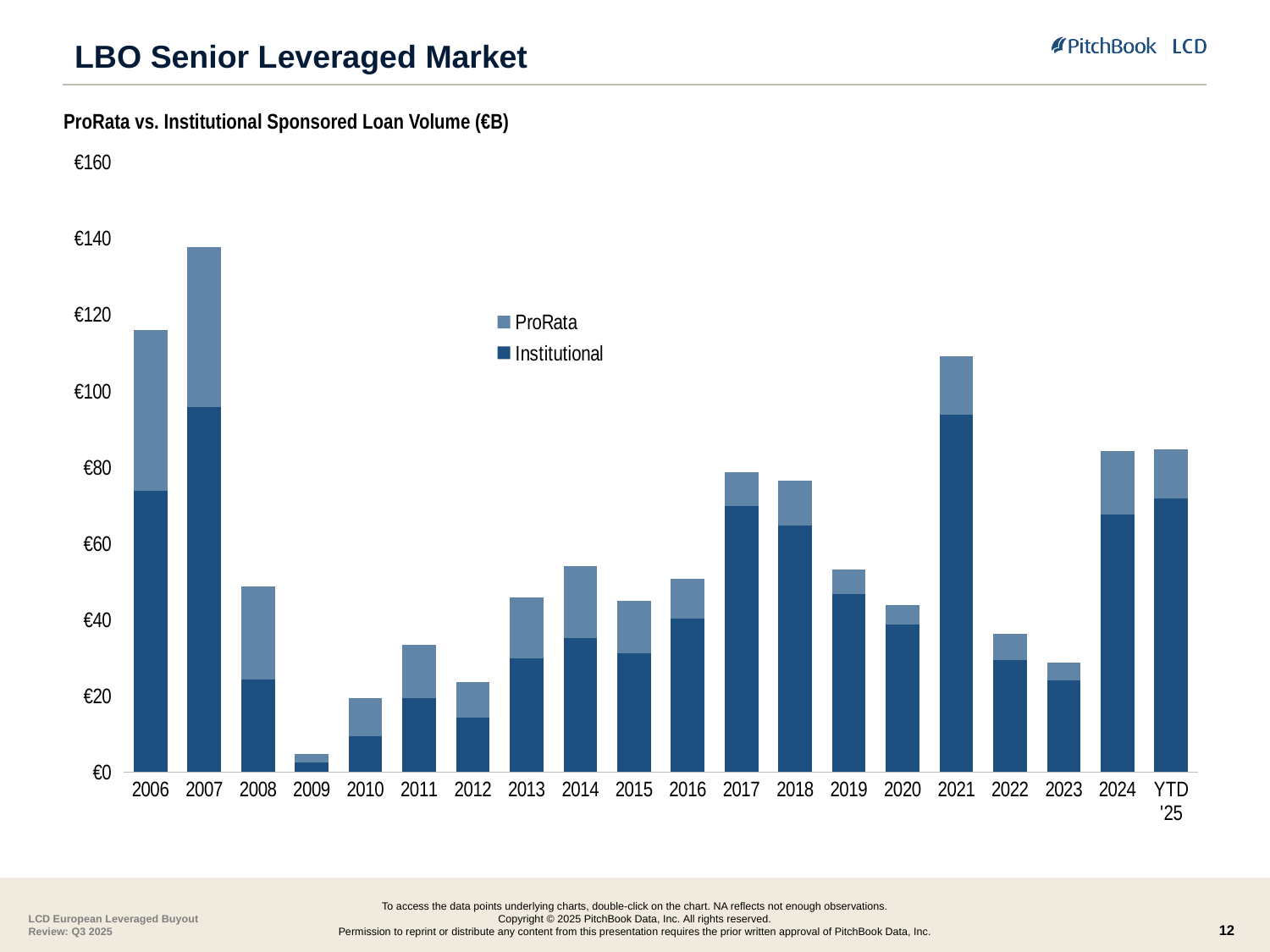
How many series does the legend list? 2 Which year has the lowest total loan volume? 2009 Is the total value for 2021 greater or less than €100? greater How many categories are shown along the x axis? 20 Which has the larger total loan volume, 2021 or 2024? 2021 Is the total value for 2007 greater or less than €120? greater What kind of chart is shown on the slide? Stacked bar chart Is the total value for 2009 greater or less than €20? less Do the total values rise or fall from 2021 to 2023? fall Which year has the highest total loan volume? 2007 What is the title of the chart? ProRata vs. Institutional Sponsored Loan Volume (€B)